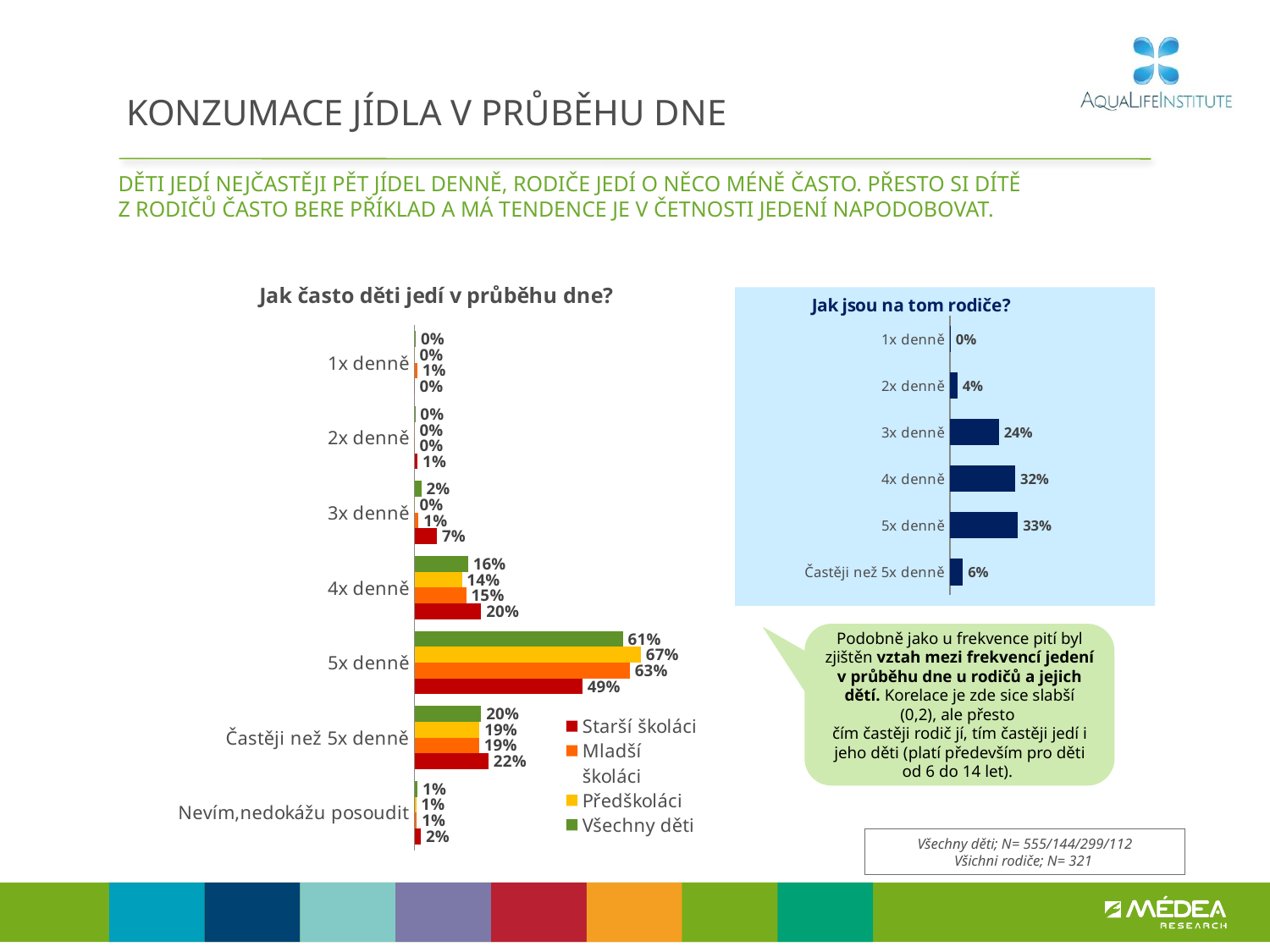
What kind of chart is 'Jak často děti jedí v průběhu dne?'? Bar chart How many categories are shown in the chart 'Jak často děti jedí v průběhu dne?'? 7 In the chart 'Jak často děti jedí v průběhu dne?', at '4x denně', which is larger: 'Starší školáci' or 'Všechny děti'? Starší školáci In the chart 'Jak často děti jedí v průběhu dne?', what is the difference between 'Předškoláci' and 'Starší školáci' at '5x denně'? 18% In the chart 'Jak jsou na tom rodiče?', what is the difference between the values for '5x denně' and '3x denně'? 9% In the chart 'Jak často děti jedí v průběhu dne?', what is the value for 'Starší školáci' at '5x denně'? 49% In the chart 'Jak často děti jedí v průběhu dne?', which series has the highest value at '5x denně'? Předškoláci In the chart 'Jak často děti jedí v průběhu dne?', what is the value for 'Předškoláci' at '5x denně'? 67% In the chart 'Jak jsou na tom rodiče?', which category has the highest value? 5x denně In the chart 'Jak jsou na tom rodiče?', what is the value for '4x denně'? 32% How many categories are shown in the chart 'Jak jsou na tom rodiče?'? 6 How many series does the legend of the chart 'Jak často děti jedí v průběhu dne?' list? 4